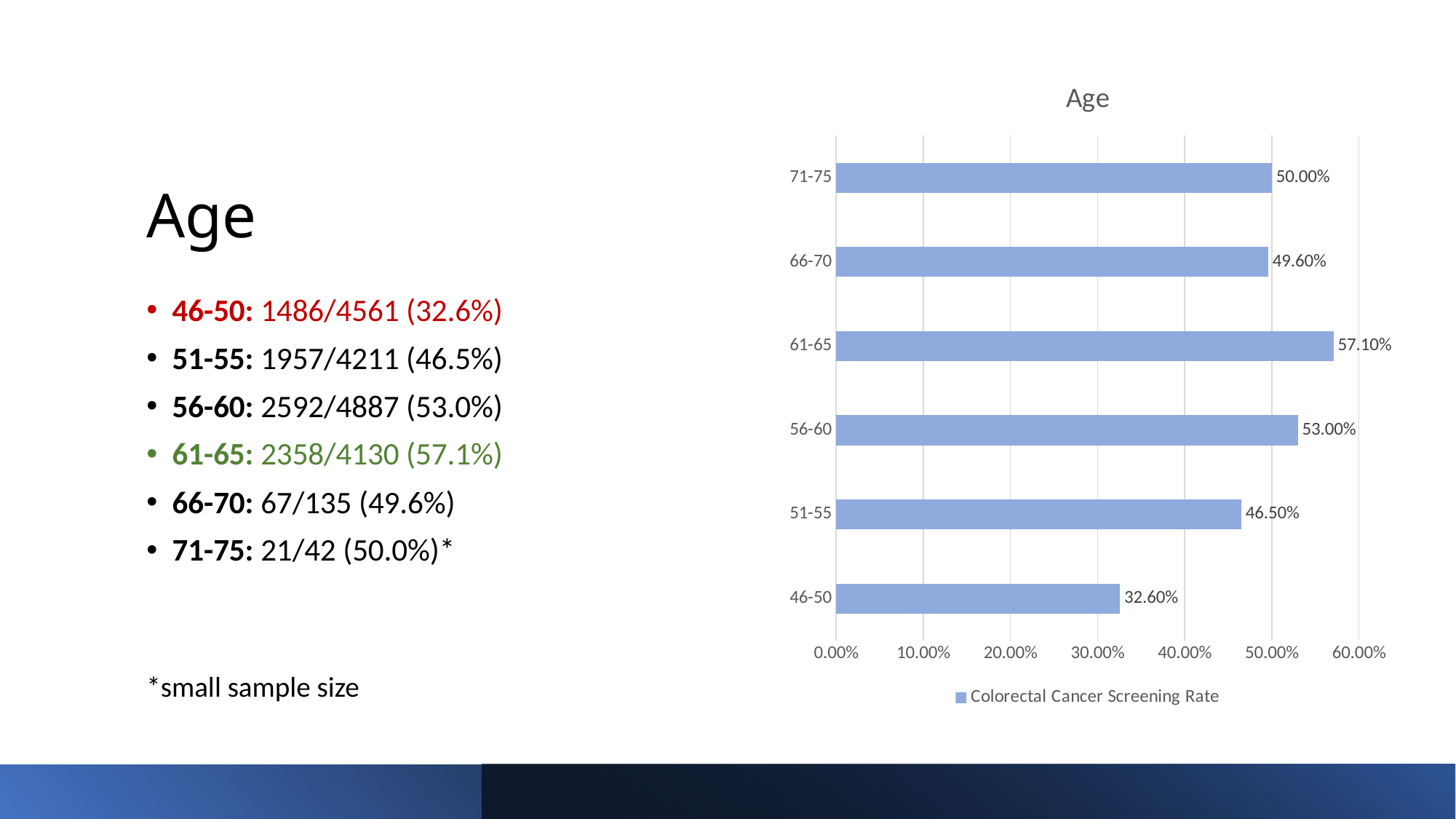
What type of chart is shown on the slide? Bar chart What is the difference in screening rate between the 61-65 and 46-50 age groups? 24.50% What is the colorectal cancer screening rate for the 46-50 age group? 32.60% How many age groups are shown in the chart? 6 Which age group has a higher screening rate, 56-60 or 51-55? 56-60 What is the name of the series shown in the chart legend? Colorectal Cancer Screening Rate What is the colorectal cancer screening rate for the 66-70 age group? 49.60% How many series does the chart legend list? 1 Which age group has the lowest colorectal cancer screening rate? 46-50 Is the screening rate for the 51-55 age group greater or less than 40.00%? greater What is the colorectal cancer screening rate for the 61-65 age group? 57.10% Which age group has the highest colorectal cancer screening rate? 61-65